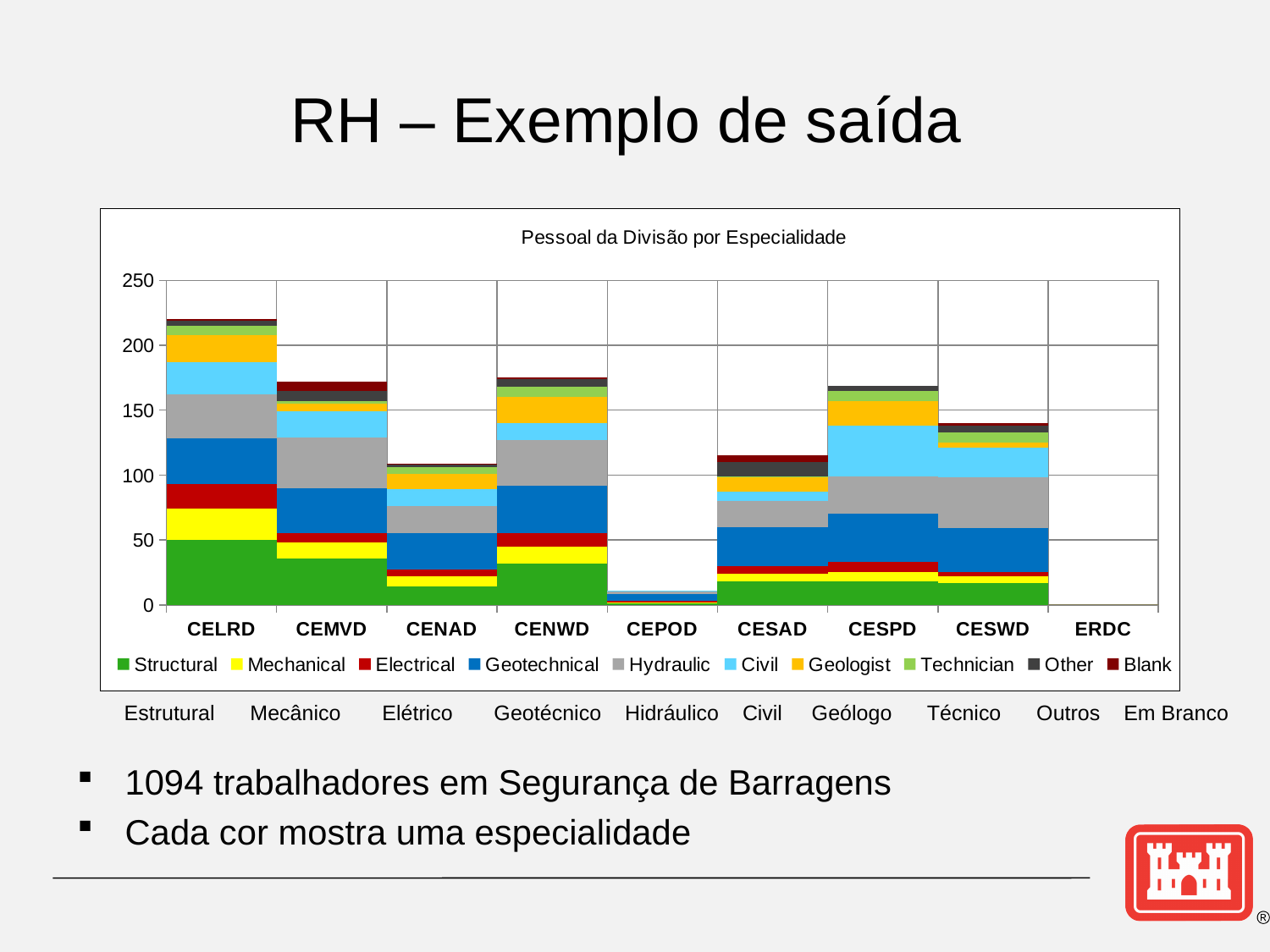
Which series is shown in green at the bottom of each stacked bar? Structural Is the total for CEMVD greater or less than 150? greater Which division has the highest total stacked bar? CELRD Which has the larger total, CESPD or CESWD? CESPD What is the title of the chart? Pessoal da Divisão por Especialidade How many divisions (categories) are shown on the x axis of the chart? 9 What kind of chart is shown on the slide? stacked bar chart Is the total for CEPOD greater or less than 50? less Which has the larger total, CELRD or CEMVD? CELRD Is the total for CESWD greater or less than 150? less How many series does the chart legend list? 10